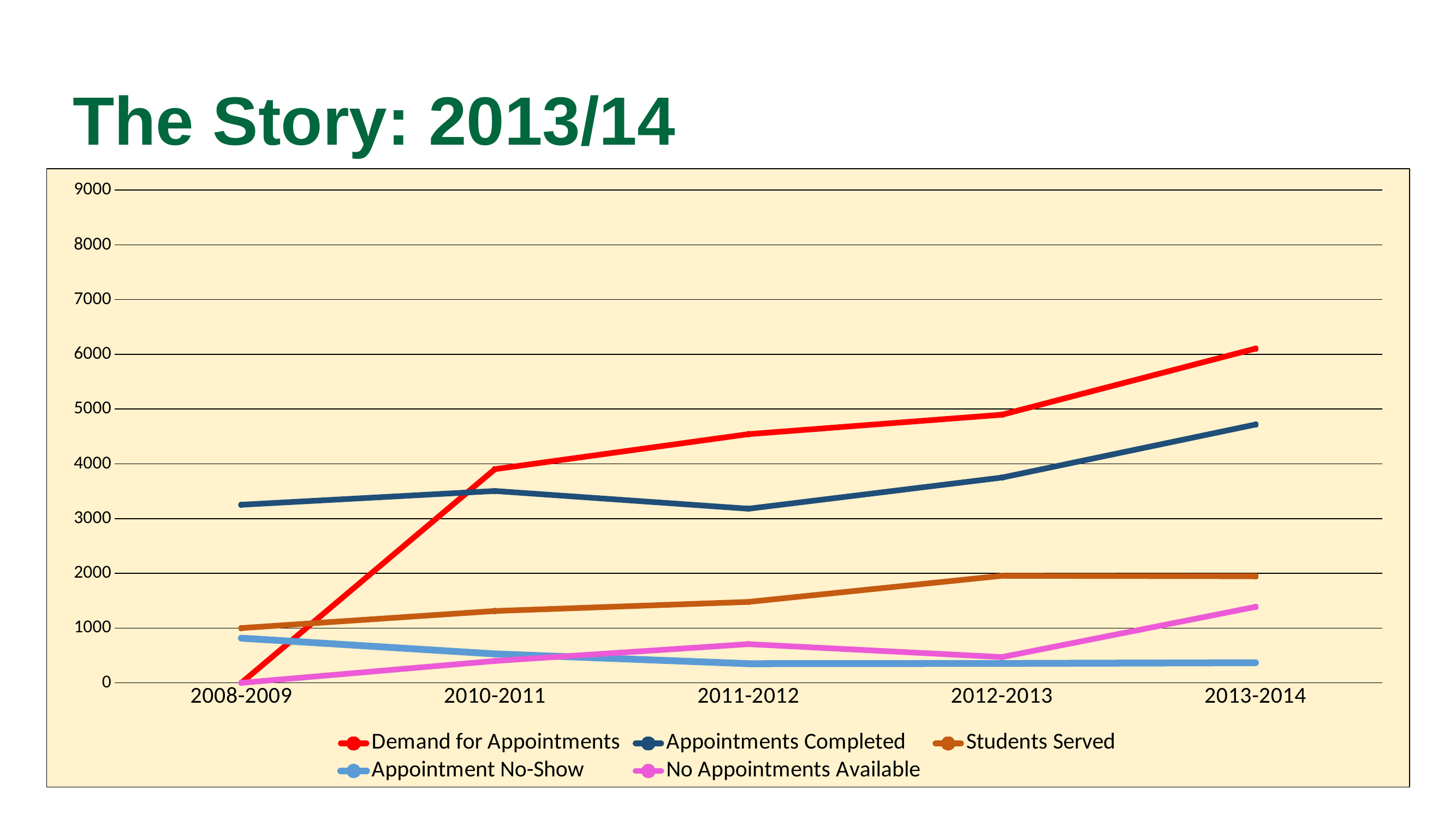
Which series has the lowest value in 2013-2014? Appointment No-Show Does the Demand for Appointments line rise or fall from 2008-2009 to 2013-2014? rise What colour is the Demand for Appointments line? red In 2011-2012, which is larger: Appointments Completed or Students Served? Appointments Completed What kind of chart is shown on the slide? line chart Is the value for Appointment No-Show in 2008-2009 greater or less than 1000? less Is the value for Demand for Appointments in 2013-2014 greater or less than 5000? greater In 2013-2014, which is larger: No Appointments Available or Appointment No-Show? No Appointments Available Which series has the highest value in 2013-2014? Demand for Appointments How many academic years are shown on the x axis? 5 Is the value for Appointments Completed in 2013-2014 greater or less than 4000? greater How many series does the legend list? 5